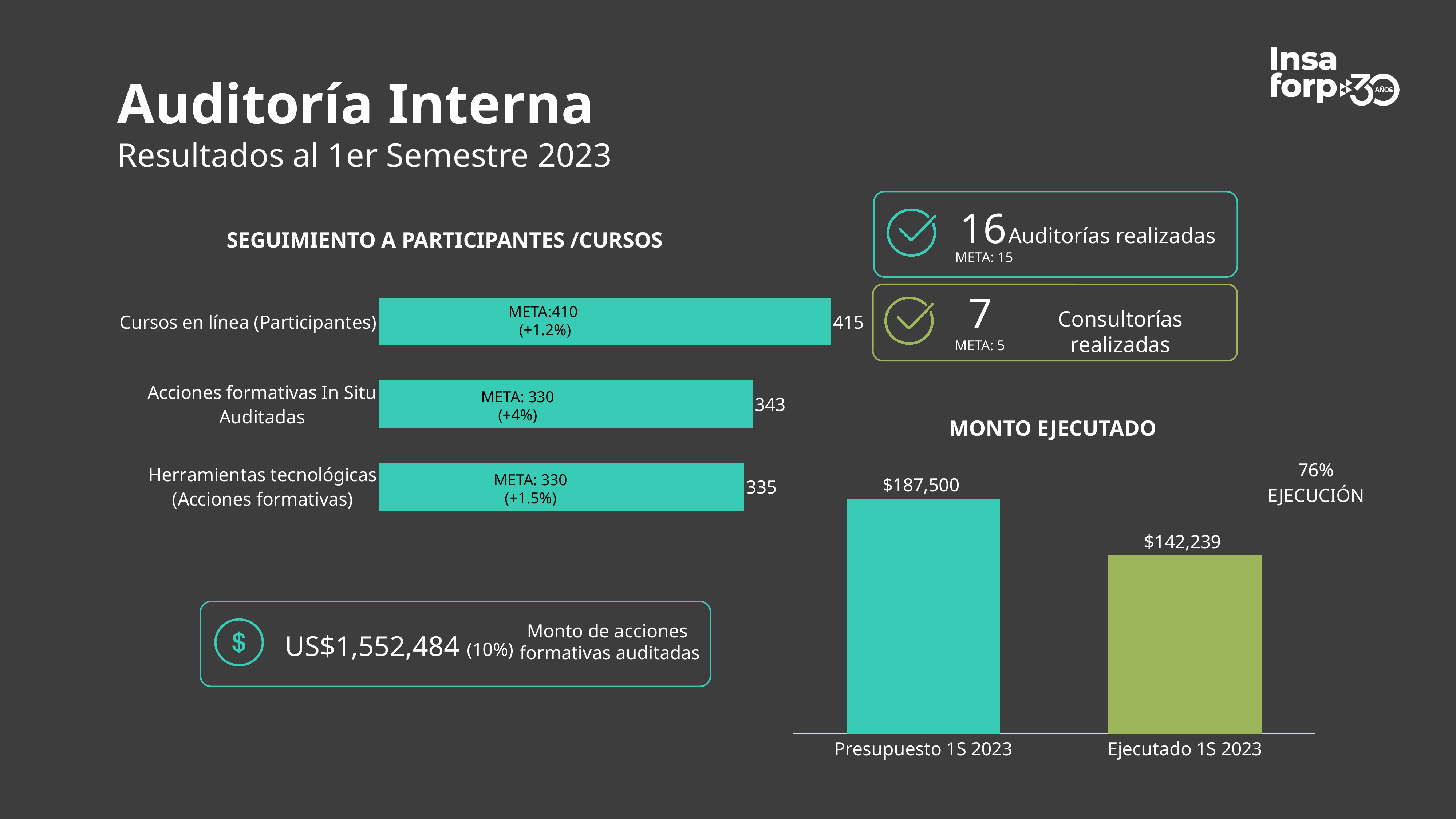
In the "SEGUIMIENTO A PARTICIPANTES /CURSOS" chart, what is the value for Acciones formativas In Situ Auditadas? 343 In the "MONTO EJECUTADO" chart, what is the value for Presupuesto 1S 2023? $187,500 In the "SEGUIMIENTO A PARTICIPANTES /CURSOS" chart, what is the value for Herramientas tecnológicas (Acciones formativas)? 335 In the "SEGUIMIENTO A PARTICIPANTES /CURSOS" chart, which category has the highest value? Cursos en línea (Participantes) What kind of chart is the "SEGUIMIENTO A PARTICIPANTES /CURSOS" chart? Bar chart In the "SEGUIMIENTO A PARTICIPANTES /CURSOS" chart, how many categories are shown? 3 In the "MONTO EJECUTADO" chart, which is larger, Presupuesto 1S 2023 or Ejecutado 1S 2023? Presupuesto 1S 2023 In the "SEGUIMIENTO A PARTICIPANTES /CURSOS" chart, what is the difference between Cursos en línea (Participantes) and Herramientas tecnológicas (Acciones formativas)? 80 In the "SEGUIMIENTO A PARTICIPANTES /CURSOS" chart, what META is printed on the bar for Cursos en línea (Participantes)? META:410 In the "MONTO EJECUTADO" chart, what is the difference between Presupuesto 1S 2023 and Ejecutado 1S 2023? $45,261 In the "SEGUIMIENTO A PARTICIPANTES /CURSOS" chart, what is the value for Cursos en línea (Participantes)? 415 In the "MONTO EJECUTADO" chart, what is the value for Ejecutado 1S 2023? $142,239